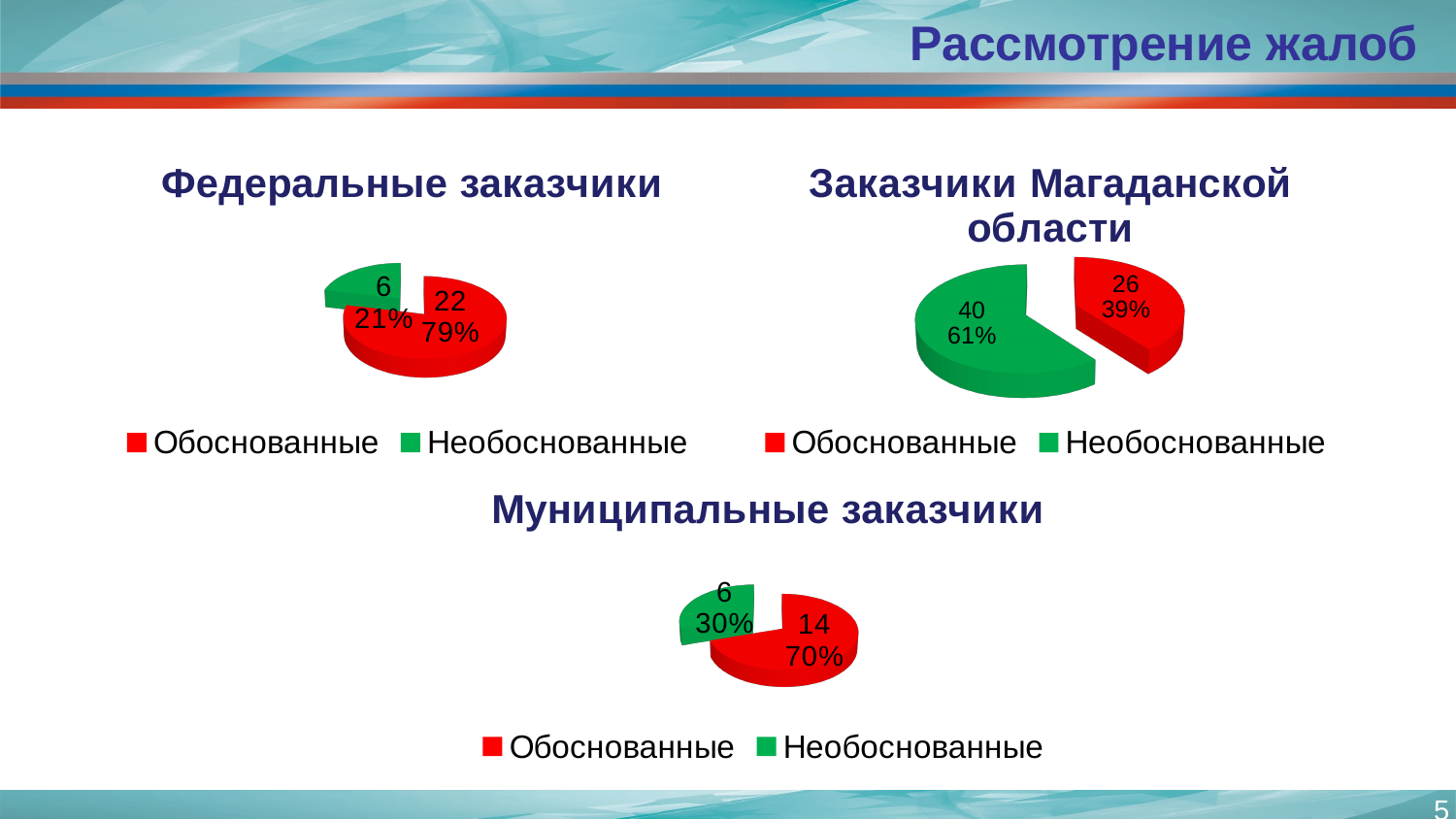
In the 'Заказчики Магаданской области' chart, what share of the pie is Обоснованные? 39% In the 'Федеральные заказчики' chart, what share of the pie is Необоснованные? 21% In the 'Заказчики Магаданской области' chart, what is the value for Необоснованные? 40 What type of chart is the 'Федеральные заказчики' chart? Pie chart How many entries does the legend of the 'Муниципальные заказчики' chart list? 2 In the 'Муниципальные заказчики' chart, what is the difference between Обоснованные and Необоснованные? 8 In the 'Муниципальные заказчики' chart, what share of the pie is Необоснованные? 30% In the 'Заказчики Магаданской области' chart, what is the total of Обоснованные and Необоснованные? 66 In the 'Муниципальные заказчики' chart, what is the value for Обоснованные? 14 In the 'Федеральные заказчики' chart, which category is the smallest? Необоснованные In the 'Федеральные заказчики' chart, what is the value for Обоснованные? 22 In the 'Заказчики Магаданской области' chart, which category is the largest? Необоснованные